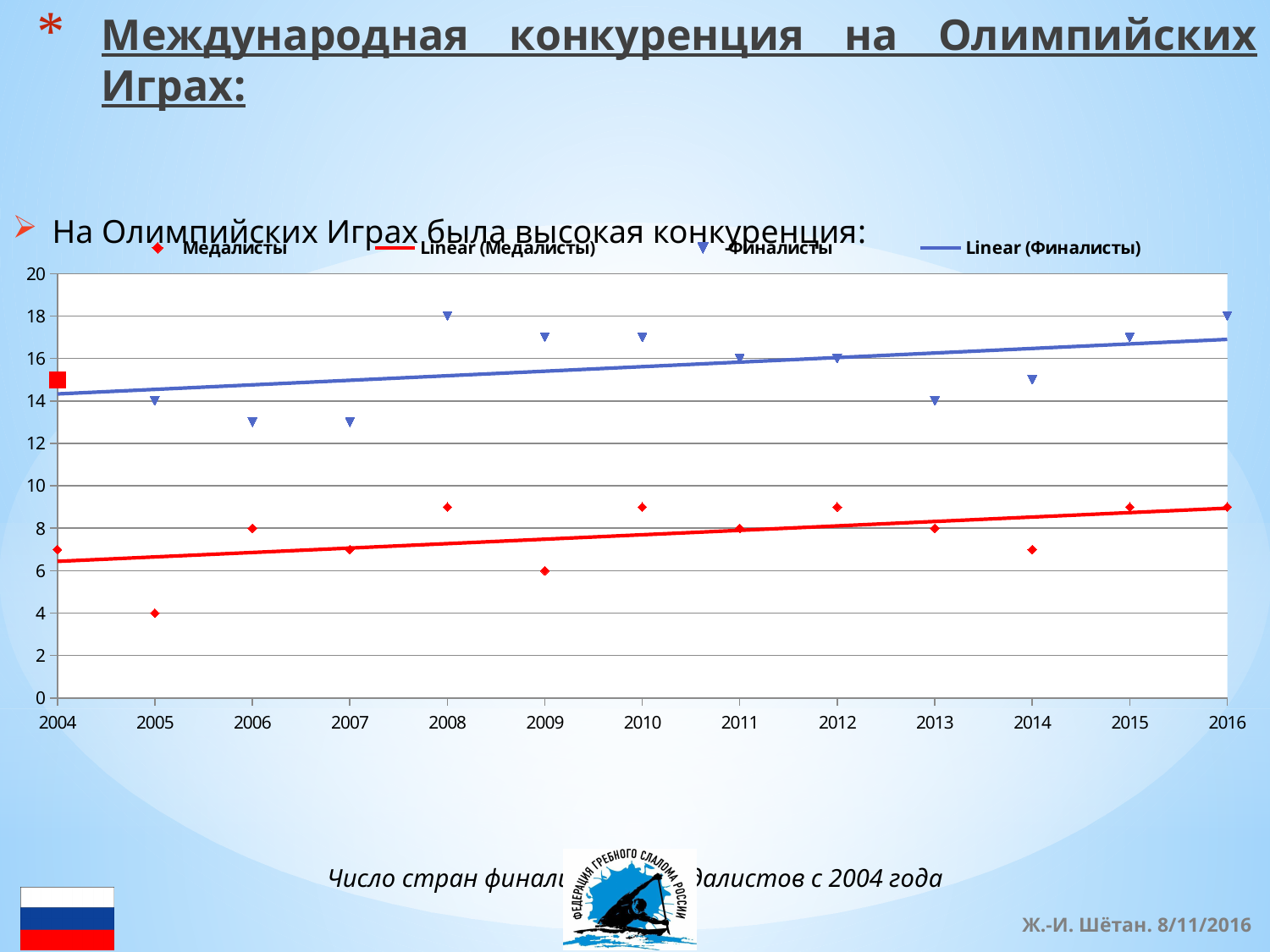
Which is larger, the Финалисты value in 2008 or in 2005? 2008 What is the value for Медалисты in 2009? 6 What is the value for Финалисты in 2008? 18 Is the value for Медалисты in 2012 greater or less than 8? greater What is the value for Медалисты in 2005? 4 Does the Linear (Медалисты) trendline rise or fall from 2004 to 2016? rises How many entries does the chart legend list? 4 Is the value for Финалисты in 2009 greater or less than 16? greater How many years are shown along the x axis of the chart? 13 What is the difference between the Финалисты value in 2008 and in 2005? 4 What kind of chart is shown on the slide? scatter chart In which year is the Медалисты value lowest? 2005